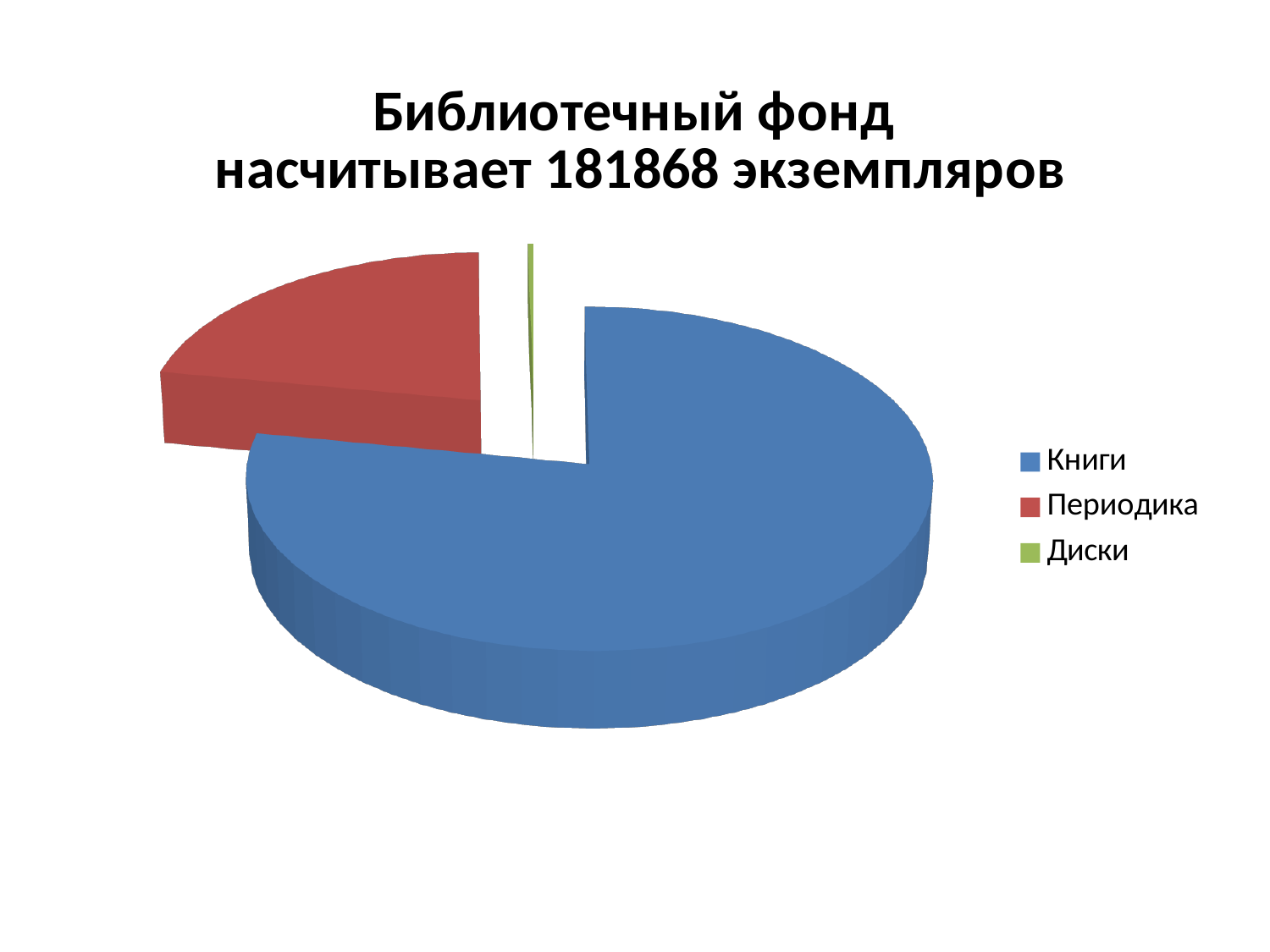
What is the title of the chart? Библиотечный фонд насчитывает 181868 экземпляров What kind of chart is shown on the slide? pie chart How many slices does the pie chart have? 3 What colour is the Периодика slice? red Which category has the largest slice of the pie? Книги Which slice is larger, Периодика or Диски? Периодика Which category has the smallest slice of the pie? Диски How many entries does the legend list? 3 Which slice is larger, Книги or Периодика? Книги